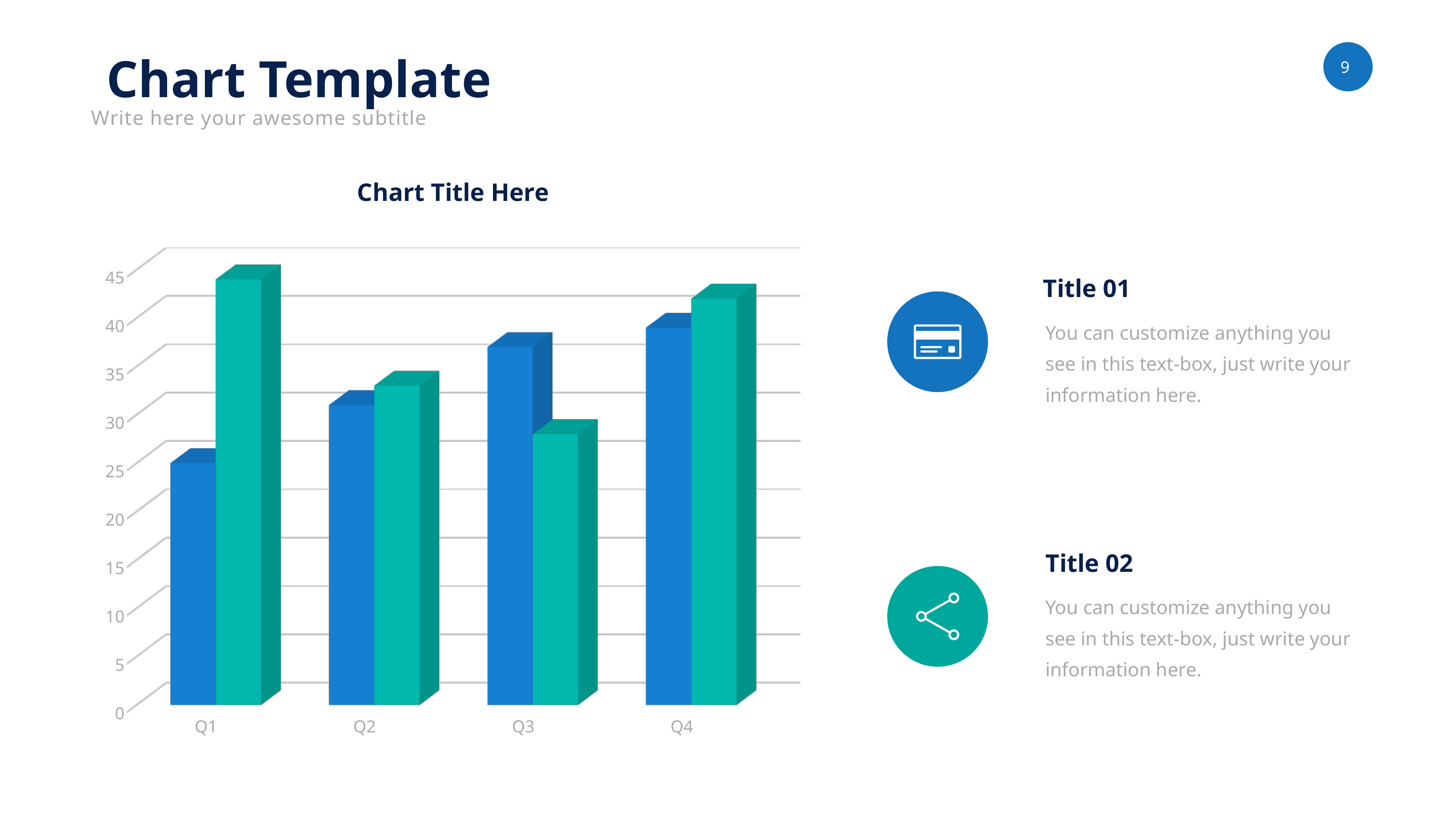
Is the value of the blue bar for Q4 greater or less than 35? greater Is the value of the teal bar for Q1 greater or less than 40? greater Which quarter has the tallest teal bar? Q1 Which quarter has the shortest blue bar? Q1 For Q1, which bar is taller, the blue one or the teal one? The teal one What kind of chart is shown on the slide? Bar chart How many categories are shown on the x axis of the chart? 4 For Q3, which bar is taller, the blue one or the teal one? The blue one What is the title of the chart? Chart Title Here Do the blue bars rise or fall from Q1 to Q4? Rise Is the value of the teal bar for Q3 greater or less than 35? less